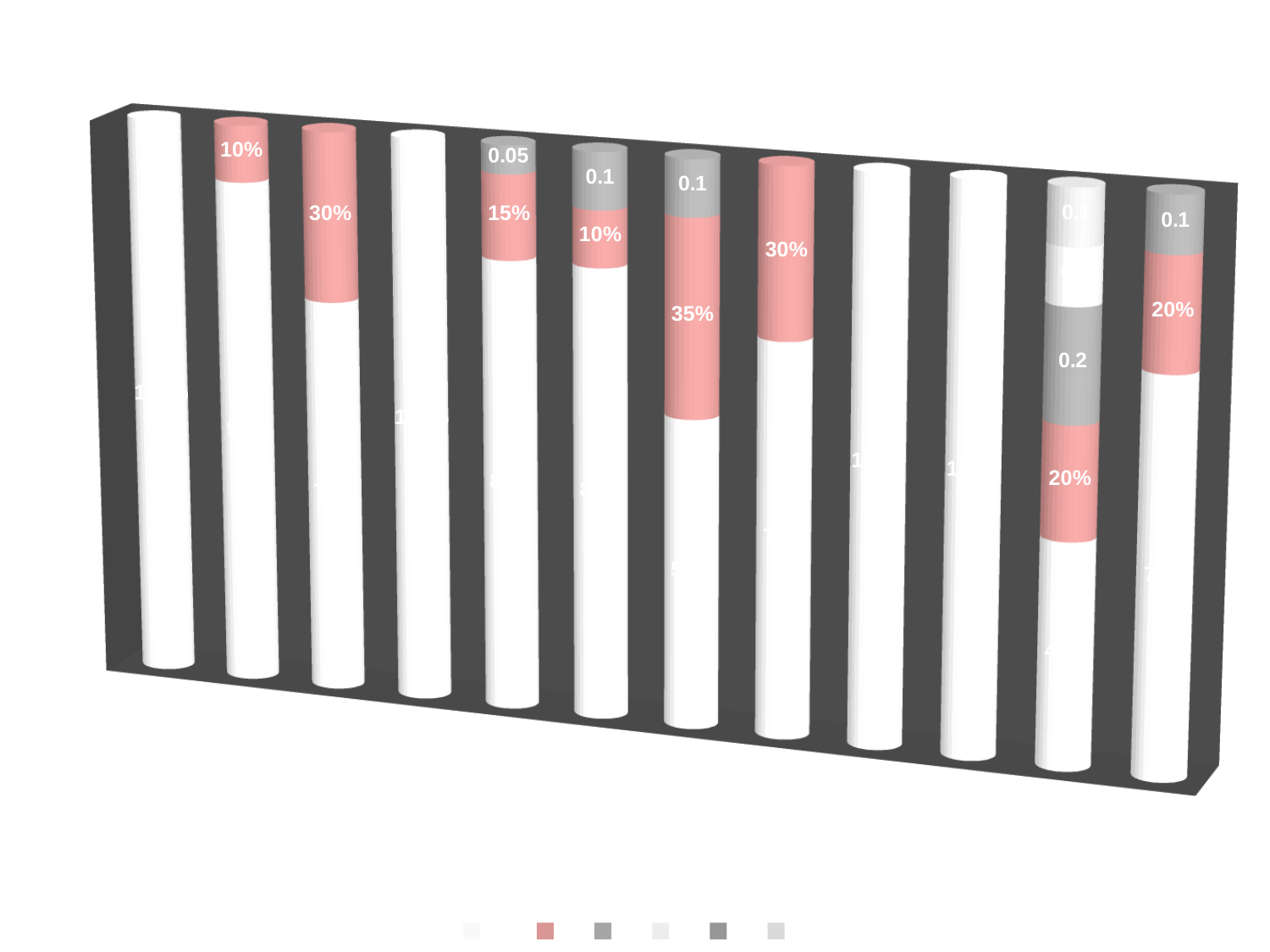
What value is labelled on the pink segment of the second bar from the left? 10% What value is labelled on the grey segment at the top of the fifth bar from the left? 0.05 What kind of chart is shown on the slide? bar chart What value is labelled on the large grey segment of the second bar from the right? 0.2 What value is labelled on the pink segment of the third bar from the left? 30% Which is larger, the pink segment of the third bar from the left or the pink segment of the second bar from the left? the third bar from the left How many series does the legend list? 6 What value is labelled on the pink segment of the seventh bar from the left? 35% How many bars are plotted in the chart? 12 Is the chart drawn in 3D? yes What value is labelled on the pink segment of the rightmost bar? 20%